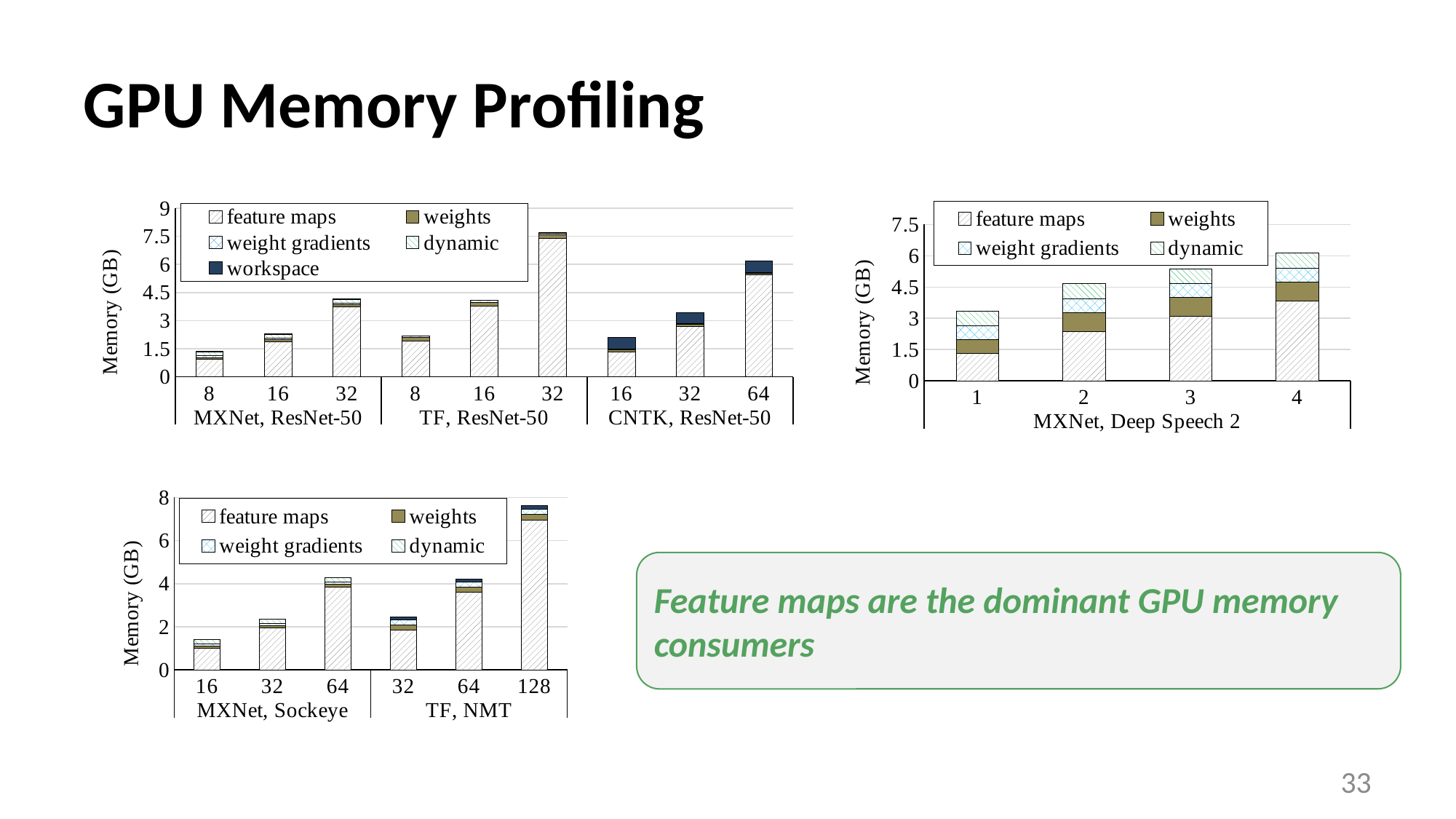
In the top-left chart (ResNet-50), is the total memory for TF, ResNet-50 at batch size 32 greater or less than 6 GB? greater In the top-left chart (ResNet-50), which bar is the shortest? MXNet, ResNet-50 at batch size 8 In the top-right chart (MXNet, Deep Speech 2), does total memory rise or fall as the x-axis value increases from 1 to 4? rise What kind of chart is the bottom-left chart (Sockeye / NMT)? stacked bar chart In the top-left chart (ResNet-50), which bar is the tallest? TF, ResNet-50 at batch size 32 In the top-left chart (ResNet-50), how many bars are plotted in total? 9 In the top-right chart (MXNet, Deep Speech 2), how many bars are plotted? 4 In the top-right chart (MXNet, Deep Speech 2), is the total memory at x = 1 greater or less than 4.5 GB? less In the top-left chart (ResNet-50), is the total memory for CNTK, ResNet-50 at batch size 16 greater or less than 3 GB? less In the top-left chart (ResNet-50), how many series does the legend list? 5 In the bottom-left chart (Sockeye / NMT), which bar is the tallest? TF, NMT at batch size 128 In the bottom-left chart (Sockeye / NMT), which is larger: the total memory for TF, NMT at batch size 64 or for MXNet, Sockeye at batch size 32? TF, NMT at batch size 64